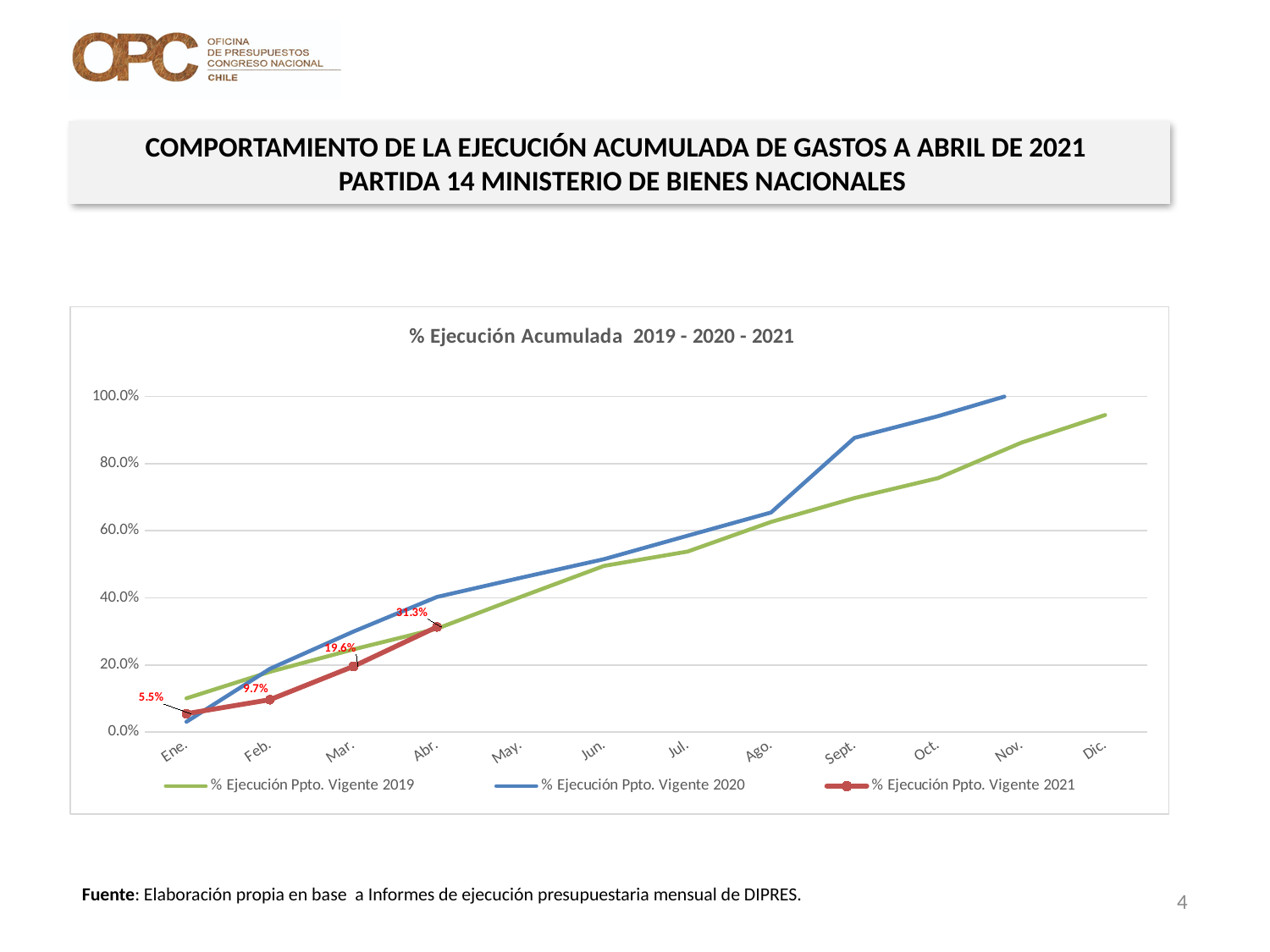
What is the value of % Ejecución Ppto. Vigente 2021 for Abr.? 31.3% How many months are shown on the x axis? 12 How many series does the legend list? 3 What is the value of % Ejecución Ppto. Vigente 2021 for Ene.? 5.5% Do the values of % Ejecución Ppto. Vigente 2021 rise or fall from Ene. to Abr.? rise What kind of chart is shown on the slide? line chart Is the value for % Ejecución Ppto. Vigente 2020 in Sept. greater or less than 80.0%? greater Is the value for % Ejecución Ppto. Vigente 2019 in Jun. greater or less than 60.0%? less What is the value of % Ejecución Ppto. Vigente 2021 for Mar.? 19.6% Which month has the highest value for % Ejecución Ppto. Vigente 2021? Abr. What is the difference between the 2021 values for Feb. and Ene.? 4.2% What is the difference between the 2021 values for Abr. and Mar.? 11.7%